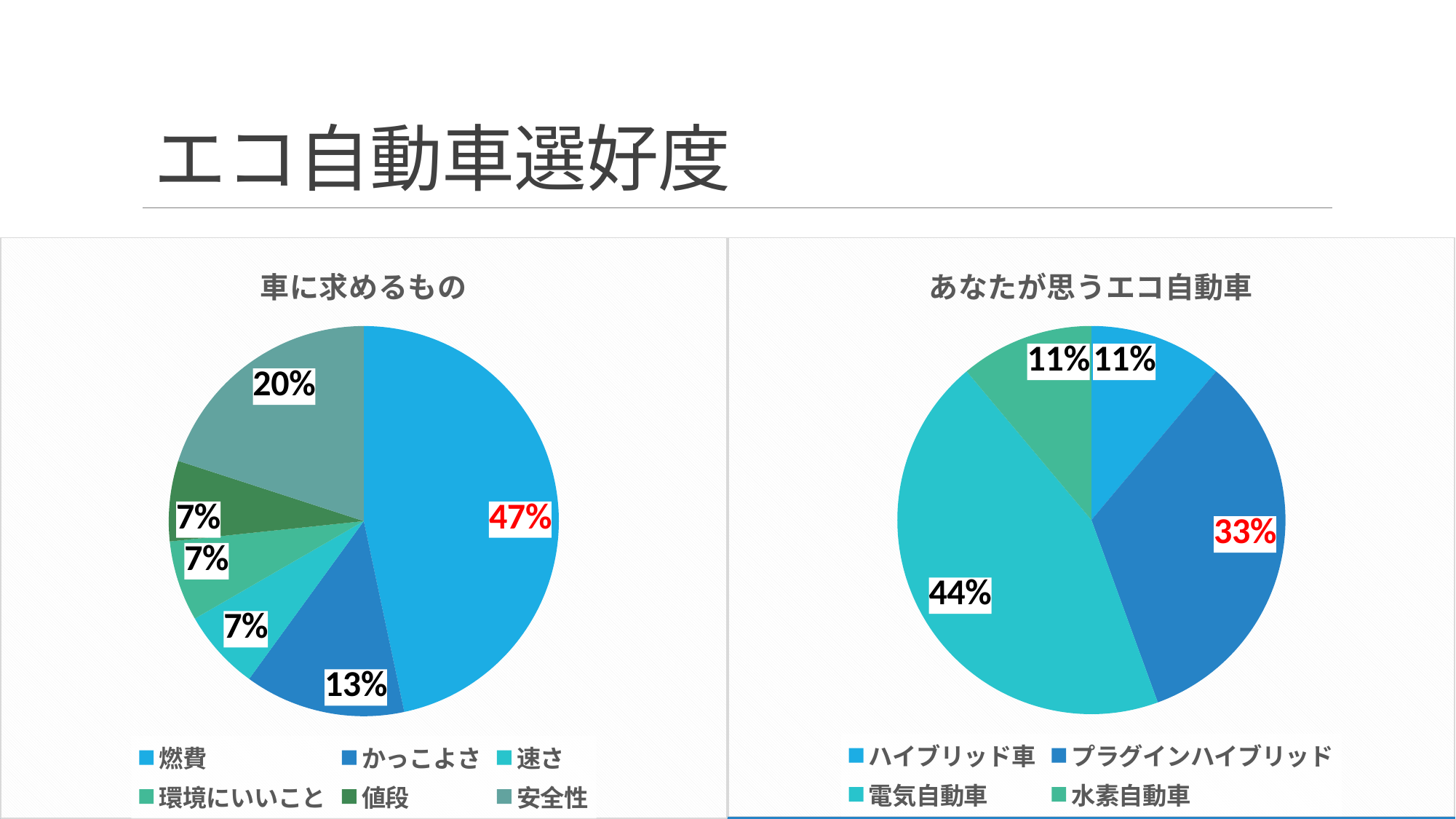
In the chart titled 車に求めるもの, what share does 安全性 have? 20% In the chart titled 車に求めるもの, what is the difference between the shares of 燃費 and 安全性? 27% What type of chart is the chart titled あなたが思うエコ自動車? Pie chart In the chart titled あなたが思うエコ自動車, which is larger, 電気自動車 or プラグインハイブリッド? 電気自動車 In the chart titled あなたが思うエコ自動車, which category has the largest slice? 電気自動車 In the chart titled 車に求めるもの, what share does かっこよさ have? 13% In the chart titled あなたが思うエコ自動車, what share does プラグインハイブリッド have? 33% In the chart titled 車に求めるもの, what share does 燃費 have? 47% In the chart titled 車に求めるもの, which category has the largest slice? 燃費 In the chart titled あなたが思うエコ自動車, how many categories does the legend list? 4 In the chart titled 車に求めるもの, how many categories are shown? 6 In the chart titled あなたが思うエコ自動車, what share does 電気自動車 have? 44%